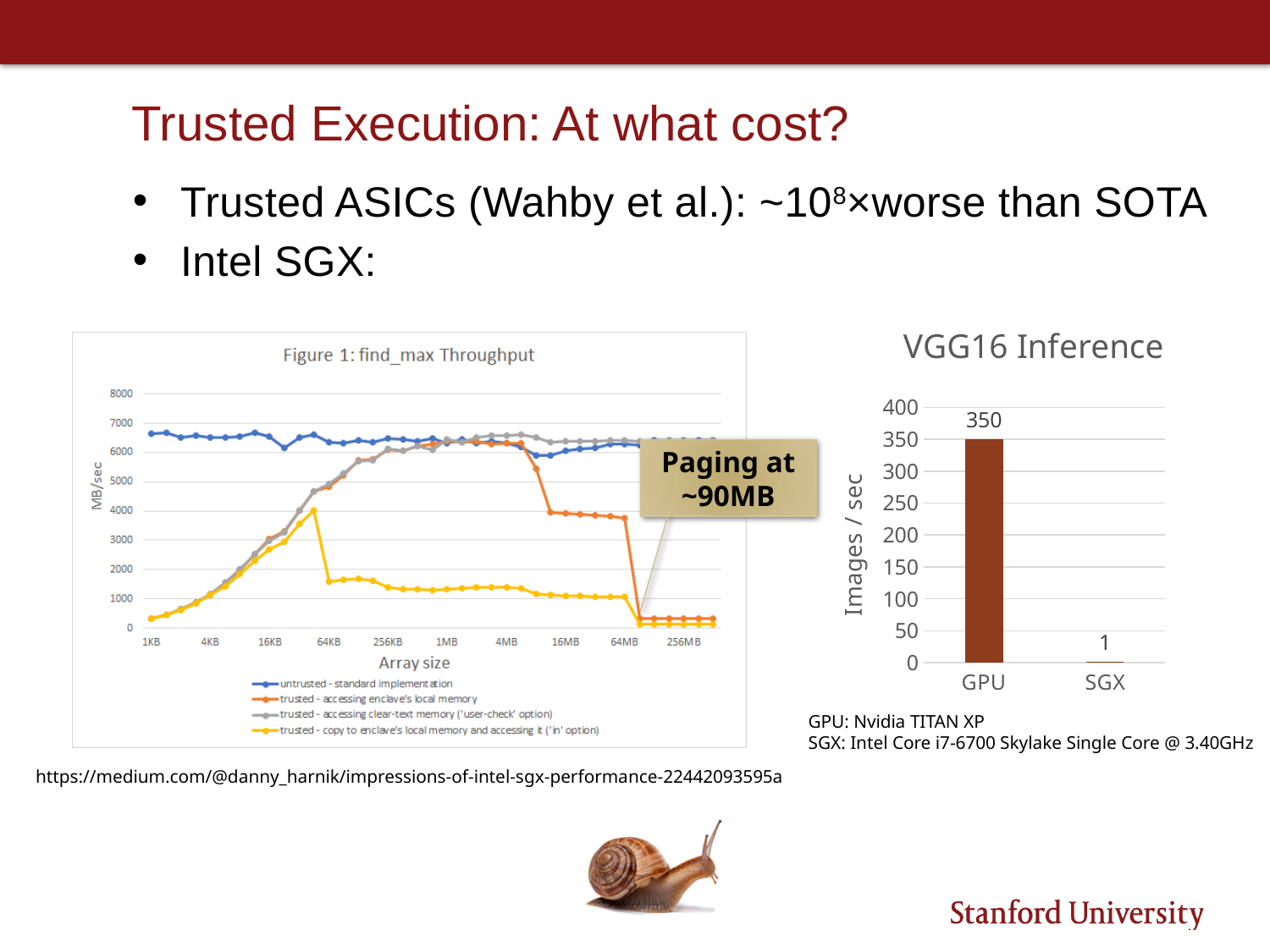
In the VGG16 Inference chart, what is the value for GPU? 350 What kind of chart is the VGG16 Inference chart? bar chart In the VGG16 Inference chart, which category has the highest value? GPU In the VGG16 Inference chart, what is the value for SGX? 1 In the Figure 1: find_max Throughput chart, how many series does the legend list? 4 In the Figure 1: find_max Throughput chart, is the value of the 'trusted - copy to enclave's local memory and accessing it ('in' option)' series at 256MB greater or less than 1000? less In the VGG16 Inference chart, which category has the lowest value? SGX What kind of chart is the Figure 1: find_max Throughput chart? line chart In the VGG16 Inference chart, what is the y-axis label? Images / sec In the VGG16 Inference chart, what is the difference between the GPU and SGX values? 349 In the VGG16 Inference chart, how many categories are shown on the x axis? 2 In the Figure 1: find_max Throughput chart, is the value of the 'untrusted - standard implementation' series at 1KB greater or less than 6000? greater